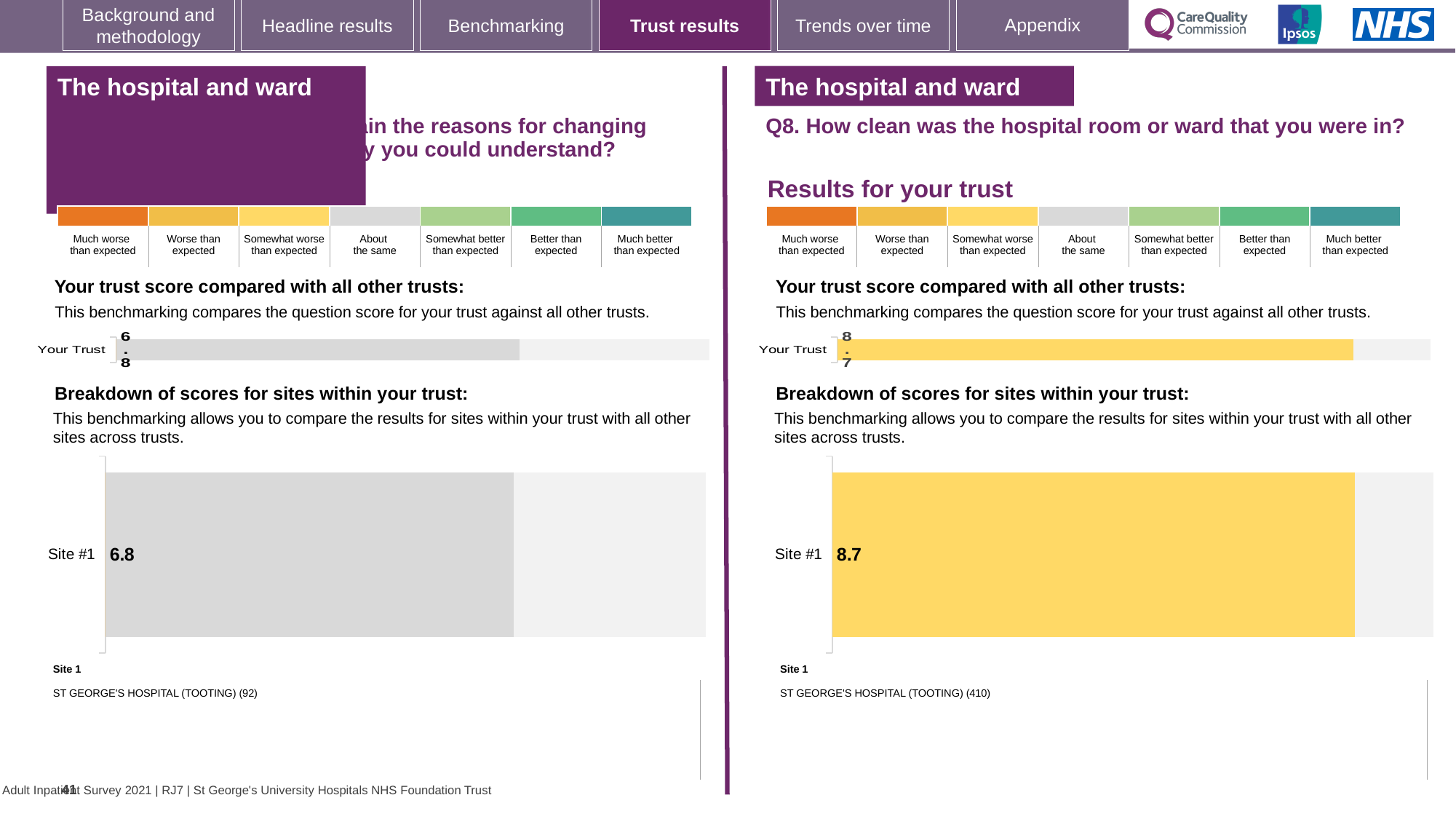
On the right-hand side of the slide (Q8, how clean was the hospital room or ward), what is the score shown for Your Trust? 8.7 How many sites are shown in the breakdown of scores for sites within your trust on the right-hand side of the slide (Q8)? 1 On the left-hand side of the slide, what score is shown for Site #1 in the breakdown of scores for sites within your trust? 6.8 Which site is listed as Site 1 on the right-hand side of the slide (Q8)? ST GEORGE'S HOSPITAL (TOOTING) (410) On the right-hand side of the slide (Q8), which benchmarking category does the colour of the Your Trust bar correspond to? Somewhat worse than expected On the left-hand side of the slide, what is the score shown for Your Trust? 6.8 Which is larger: the Your Trust score on the left-hand side of the slide or the Your Trust score on the right-hand side (Q8)? Right-hand side (Q8), 8.7 What is the difference between the Site #1 score on the right-hand side (Q8) and the Site #1 score on the left-hand side of the slide? 1.9 On the left-hand side of the slide, which benchmarking category does the colour of the Site #1 bar correspond to? About the same How many sites are shown in the breakdown of scores for sites within your trust on the left-hand side of the slide? 1 On the right-hand side of the slide (Q8), what score is shown for Site #1 in the breakdown of scores for sites within your trust? 8.7 What kind of chart is used to show the Site #1 score on the right-hand side of the slide (Q8)? Bar chart